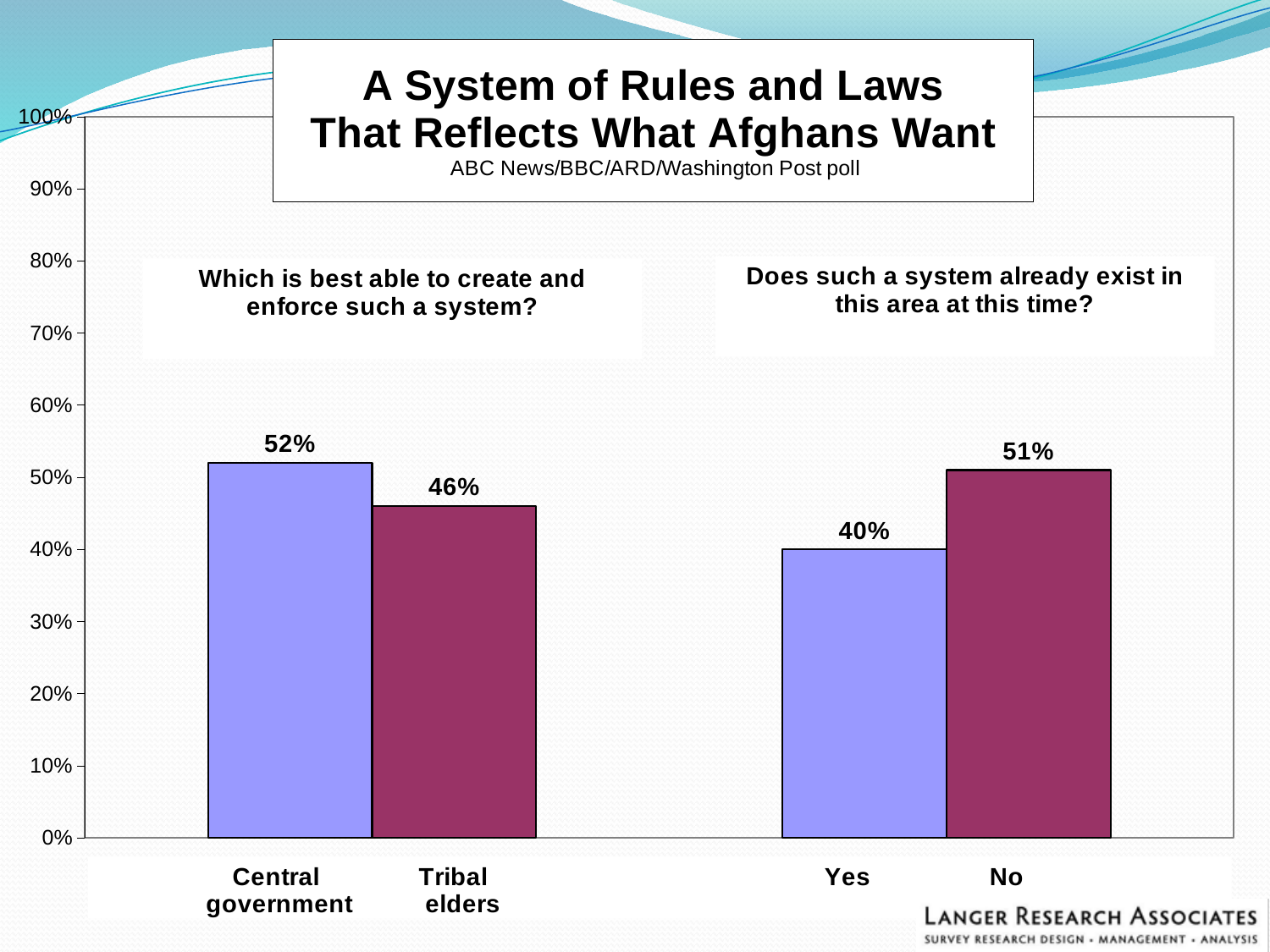
What is the difference between the Central government and Tribal elders percentages? 6% What percentage is shown for Tribal elders? 46% Which bar on the chart has the lowest value? Yes How many bars are plotted on the chart? 4 Which bar on the chart has the highest value? Central government What percentage answered No to whether such a system already exists in this area? 51% What kind of chart is shown on the slide? Bar chart What is the difference between the No and Yes percentages? 11% What percentage answered Yes to whether such a system already exists in this area? 40% What percentage is shown for Central government? 52% Which is larger, the value for Yes or the value for No? No Which poll is credited in the chart's subtitle? ABC News/BBC/ARD/Washington Post poll